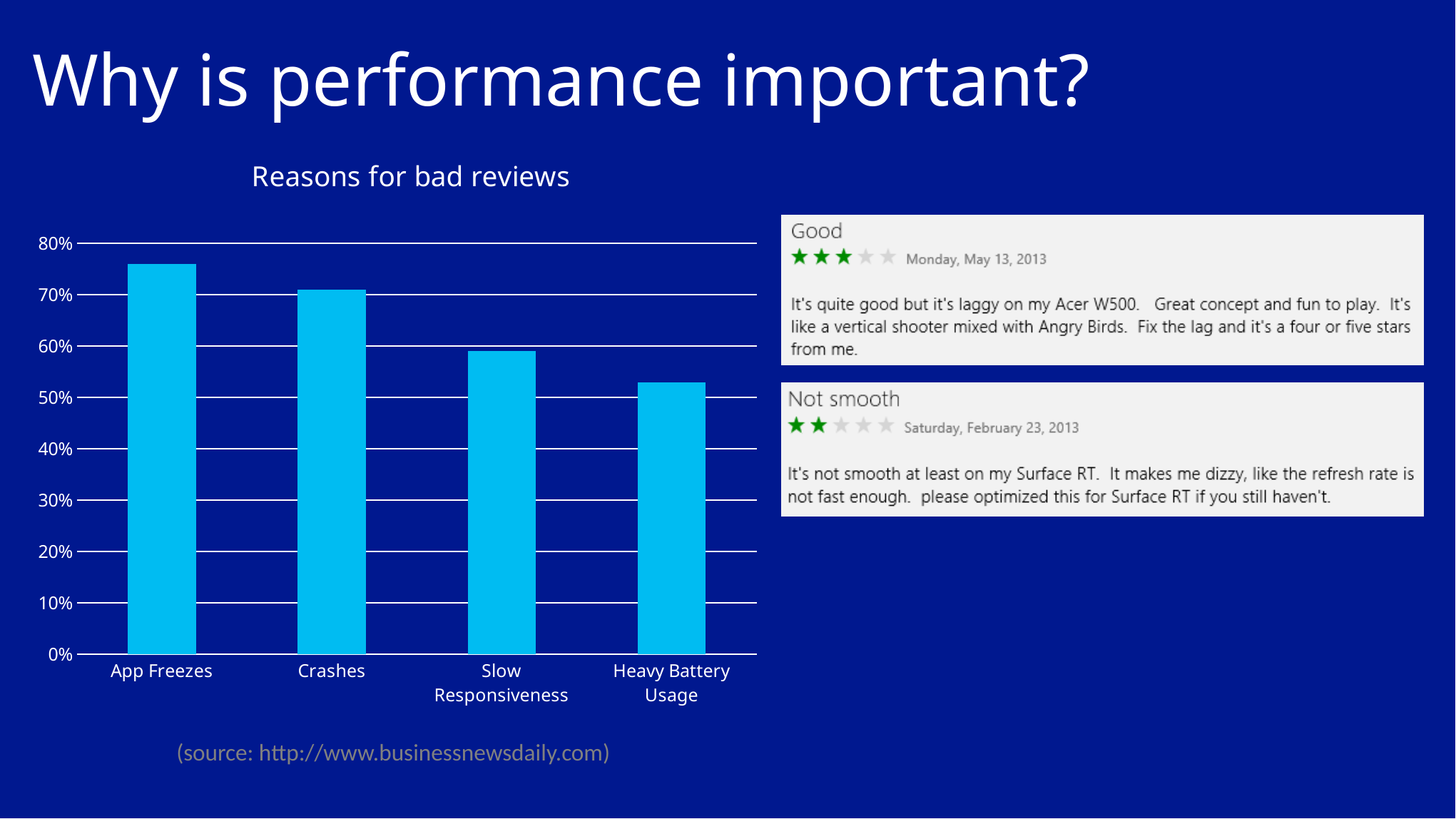
What kind of chart is shown under the title "Reasons for bad reviews"? bar chart Which reason for bad reviews has the highest bar? App Freezes Is the value for Slow Responsiveness greater or less than 50%? greater Which is larger, the value for Crashes or the value for Slow Responsiveness? Crashes Is the value for Crashes greater or less than 80%? less Is the value for App Freezes greater or less than 70%? greater How many categories are shown on the x axis of the "Reasons for bad reviews" chart? 4 Do the bar values rise or fall from left to right across the x axis? fall Which is larger, the value for App Freezes or the value for Heavy Battery Usage? App Freezes Which reason for bad reviews has the lowest bar? Heavy Battery Usage What is the title of the chart on the slide? Reasons for bad reviews